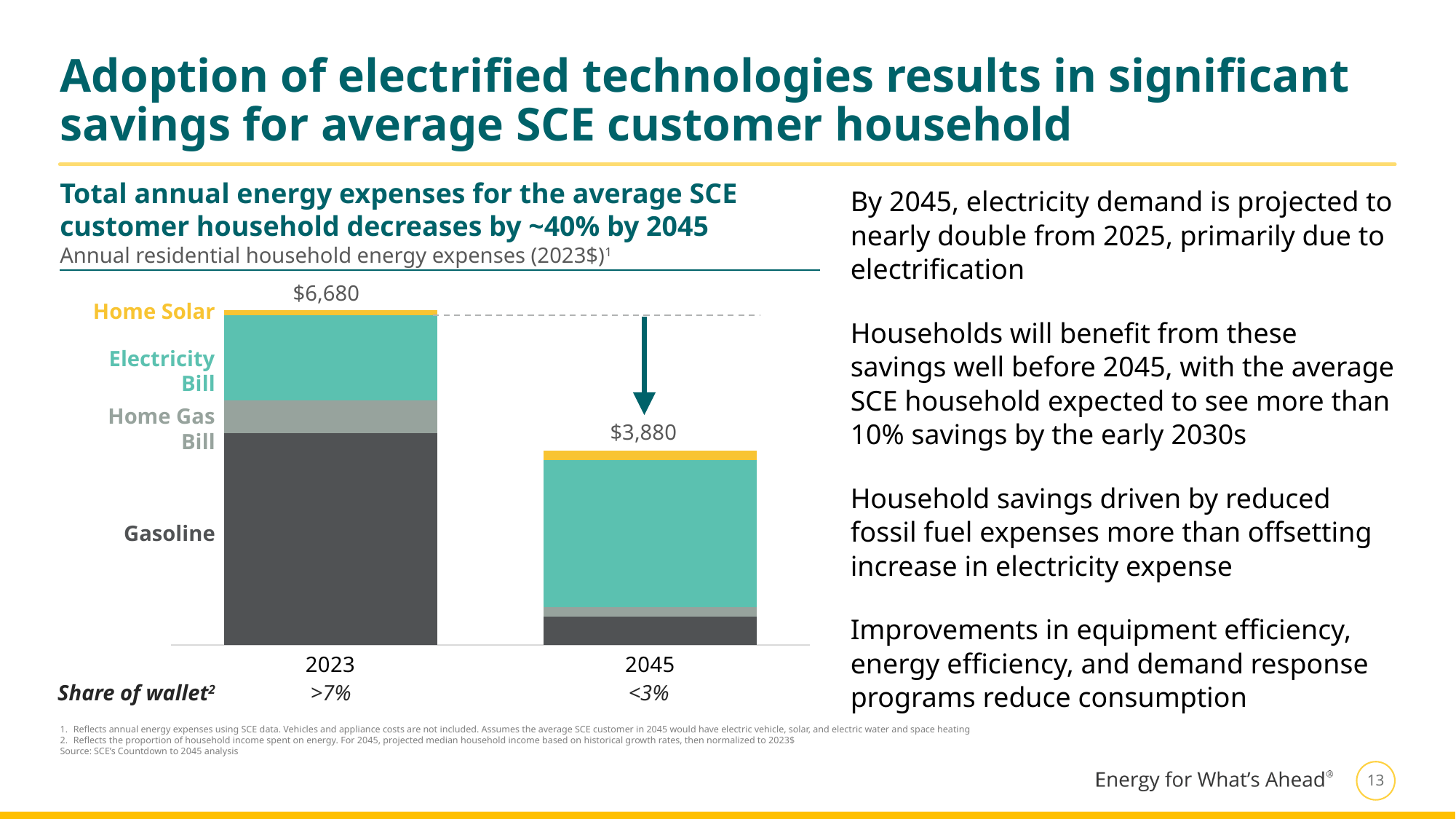
What share of wallet is shown beneath the 2045 bar? <3% What is the difference between the 2023 total and the 2045 total? $2,800 What is the total annual energy expense shown for the 2023 bar? $6,680 How many bars (years) are plotted in the chart? 2 How many expense categories are stacked in each bar? 4 Do total household energy expenses rise or fall from 2023 to 2045? Fall Which expense category is the largest segment of the 2045 bar? Electricity Bill What is the total annual energy expense shown for the 2045 bar? $3,880 Which expense category is the largest segment of the 2023 bar? Gasoline Is the Gasoline segment larger in 2023 or in 2045? 2023 What kind of chart is shown on the slide? Stacked bar chart Which year has the higher total annual energy expense, 2023 or 2045? 2023